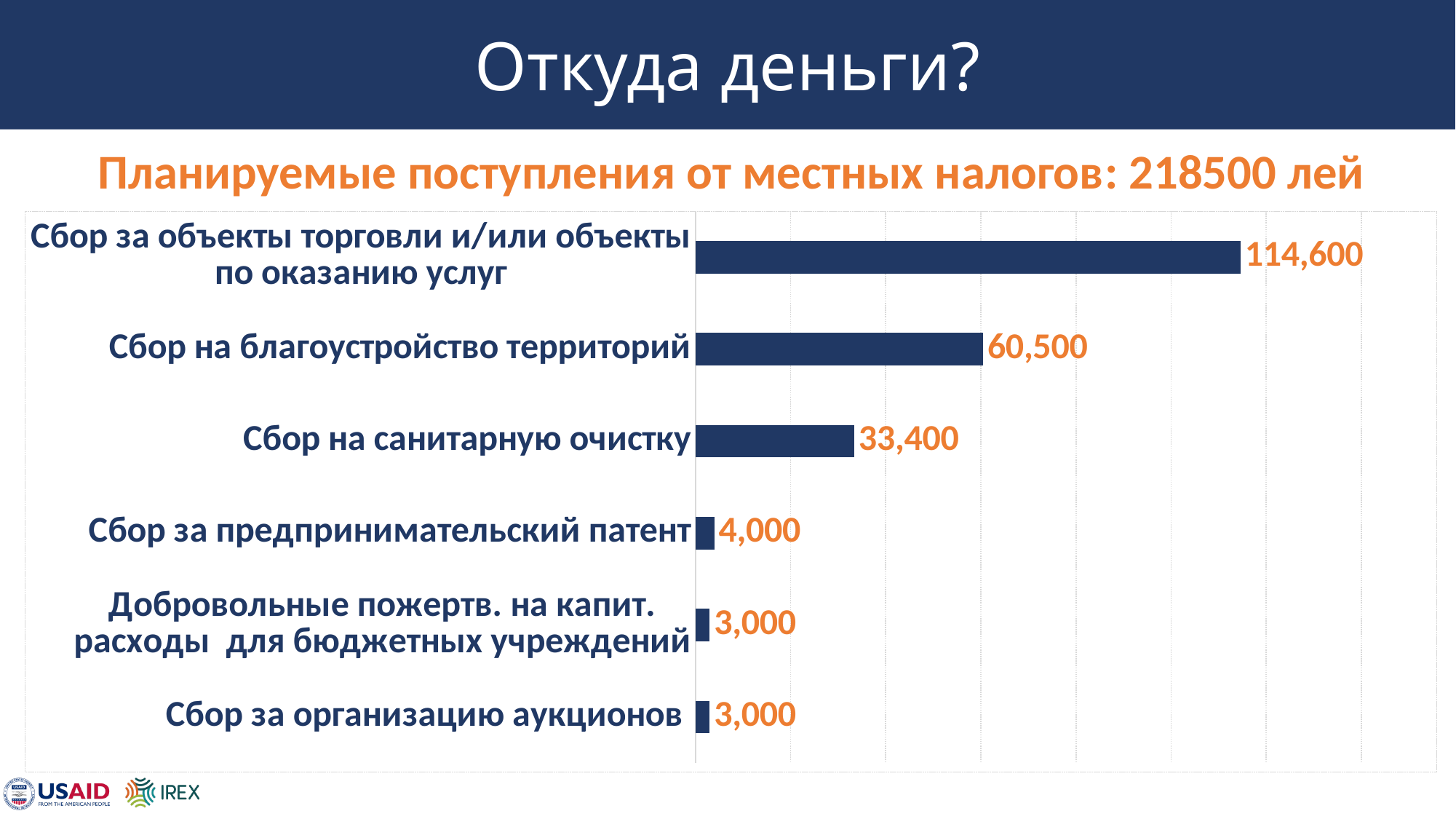
Which is larger: «Сбор на санитарную очистку» or «Сбор за предпринимательский патент»? Сбор на санитарную очистку What type of chart is shown on the slide? Bar chart What is the difference between «Сбор за объекты торговли и/или объекты по оказанию услуг» and «Сбор на благоустройство территорий»? 54,100 What is the value shown for «Сбор на благоустройство территорий»? 60,500 What is the value shown for «Сбор на санитарную очистку»? 33,400 How many categories have a value of 3,000? 2 What is the value shown for «Сбор за предпринимательский патент»? 4,000 What is the planned value for «Сбор за объекты торговли и/или объекты по оказанию услуг»? 114,600 What is the difference between «Сбор на благоустройство территорий» and «Сбор на санитарную очистку»? 27,100 How many categories are shown in the chart? 6 According to the chart heading, what is the total planned revenue from local taxes? 218500 лей Which category has the highest planned revenue? Сбор за объекты торговли и/или объекты по оказанию услуг